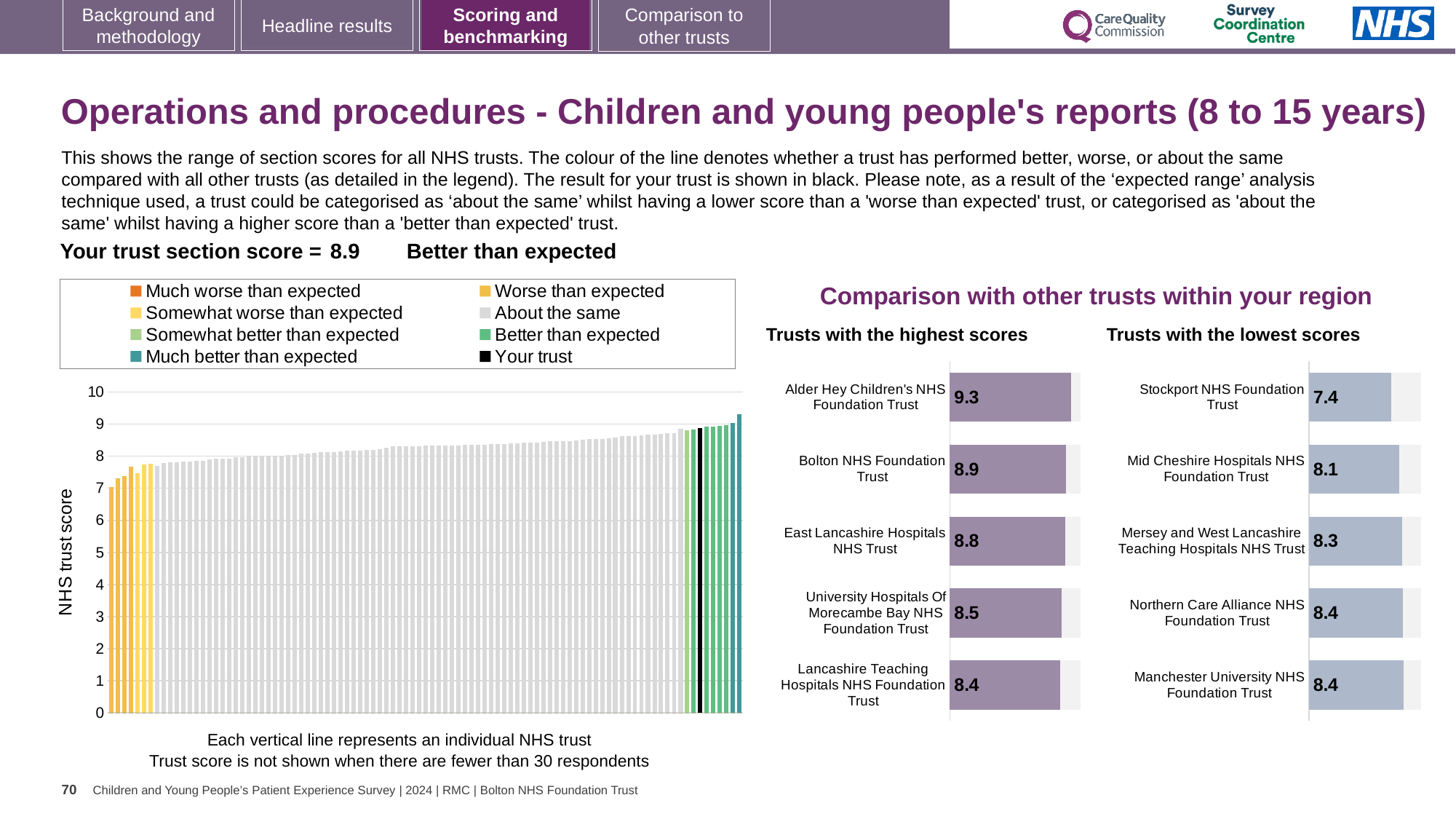
In the NHS trust score chart on the left, is the value of the leftmost bar greater or less than 8? less How many entries does the legend of the NHS trust score chart on the left list? 8 In the 'Trusts with the highest scores' chart, what is the difference between the scores of Alder Hey Children's NHS Foundation Trust and Bolton NHS Foundation Trust? 0.4 In the 'Trusts with the lowest scores' chart, which has the larger score: Mid Cheshire Hospitals NHS Foundation Trust or Mersey and West Lancashire Teaching Hospitals NHS Trust? Mersey and West Lancashire Teaching Hospitals NHS Trust In the 'Trusts with the highest scores' chart, what is the score for Alder Hey Children's NHS Foundation Trust? 9.3 In the 'Trusts with the lowest scores' chart, what is the score for Stockport NHS Foundation Trust? 7.4 In the 'Trusts with the lowest scores' chart, which trust has the lowest score? Stockport NHS Foundation Trust In the NHS trust score chart on the left, what is the section score for your trust (the black bar)? 8.9 What kind of chart is the NHS trust score chart on the left of the slide? Bar chart In the 'Trusts with the highest scores' chart, which trust has the highest score? Alder Hey Children's NHS Foundation Trust In the NHS trust score chart on the left, do the bar values rise or fall from left to right? Rise How many trusts are listed in the 'Trusts with the highest scores' chart? 5